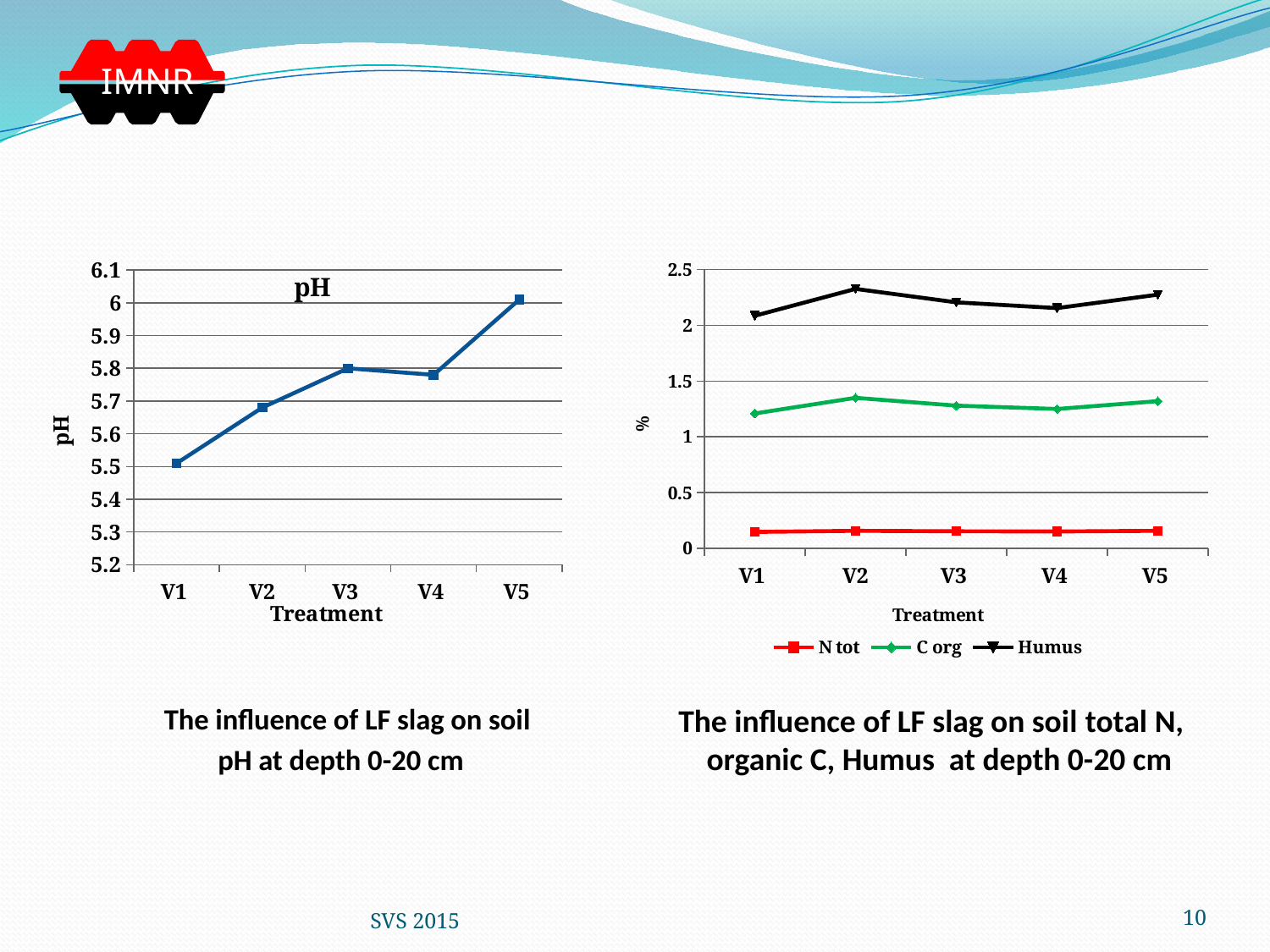
In the right chart (total N, organic C, Humus), is the N tot value for V3 greater or less than 0.5? less In the left chart (pH), is the value for V5 greater or less than 5.9? greater How many series does the legend of the right chart (total N, organic C, Humus) list? 3 What kind of chart is the left chart (pH)? line chart In the left chart (pH), which has the higher pH, V2 or V3? V3 In the left chart (pH), is the value for V1 greater or less than 5.6? less In the left chart (pH), which treatment has the highest pH? V5 In the right chart (total N, organic C, Humus), which series has the lowest values across all treatments? N tot How many treatments are plotted on the x axis of the left chart (pH)? 5 In the right chart (total N, organic C, Humus), which series has the highest values across all treatments? Humus In the left chart (pH), which treatment has the lowest pH? V1